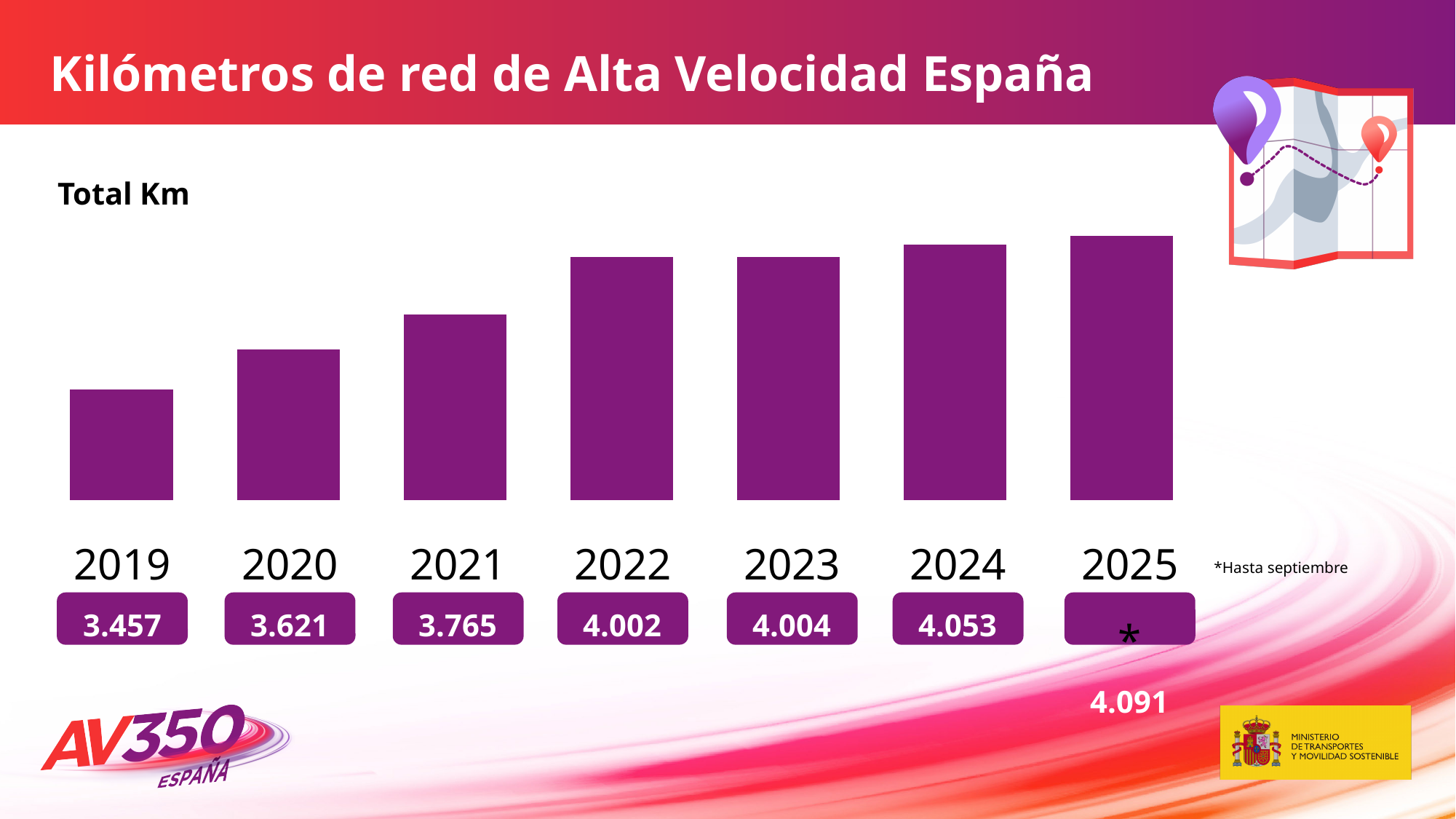
Which is larger, the value for 2021 or the value for 2022? 2022 Which year has the lowest value? 2019 Do the values rise or fall from 2019 to 2025? rise How many years are shown in the chart? 7 Which year has the highest value? 2025 What is the difference between the values for 2024 and 2023? 49 What is the value for 2024? 4.053 What is the value for 2019? 3.457 What is the title of the chart? Kilómetros de red de Alta Velocidad España What kind of chart is shown on the slide? bar chart What is the value for 2022? 4.002 What is the difference between the values for 2020 and 2019? 164